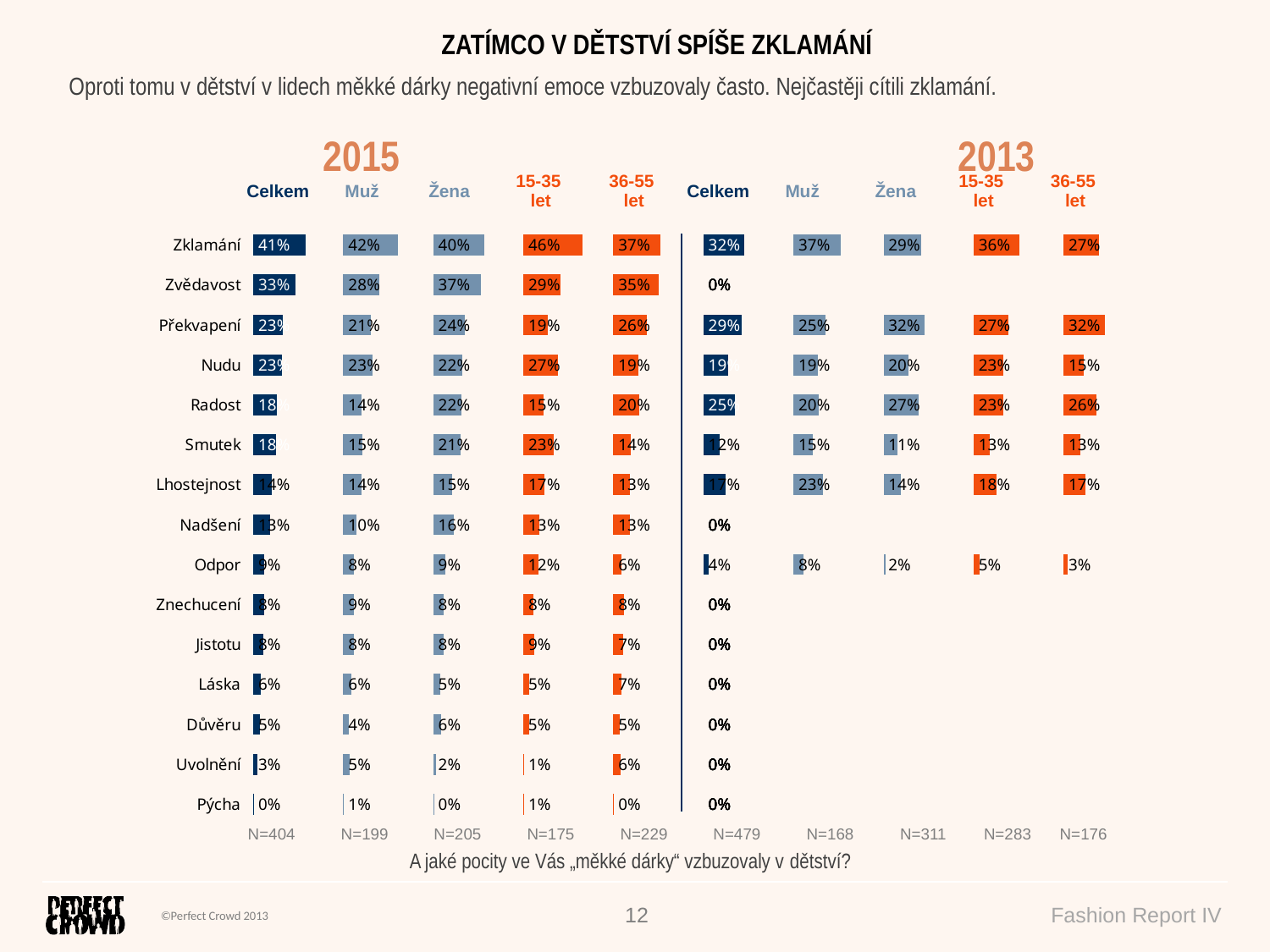
In the 2015 36-55 let chart, what is the value for Překvapení? 26% In the 2015 Celkem chart, which category has the highest value? Zklamání In the 2013 Celkem chart, what is the value for Překvapení? 29% In the 2015 Celkem chart, what is the value for Zklamání? 41% What type of chart is used to show the values on this slide? Bar chart In the 2013 Muž chart, what is the value for Lhostejnost? 23% Which is larger: Zvědavost in the 2015 Žena chart or Zvědavost in the 2015 Muž chart? 2015 Žena What is the sample size (N) shown under the 2013 Celkem chart? N=479 How many emotion categories are listed in the 2015 Celkem chart? 15 In the 2015 15-35 let chart, what is the value for Zklamání? 46% In the 2013 Žena chart, which category has the highest value? Překvapení In the 2015 Muž chart, what is the difference between Zklamání and Zvědavost? 14 percentage points